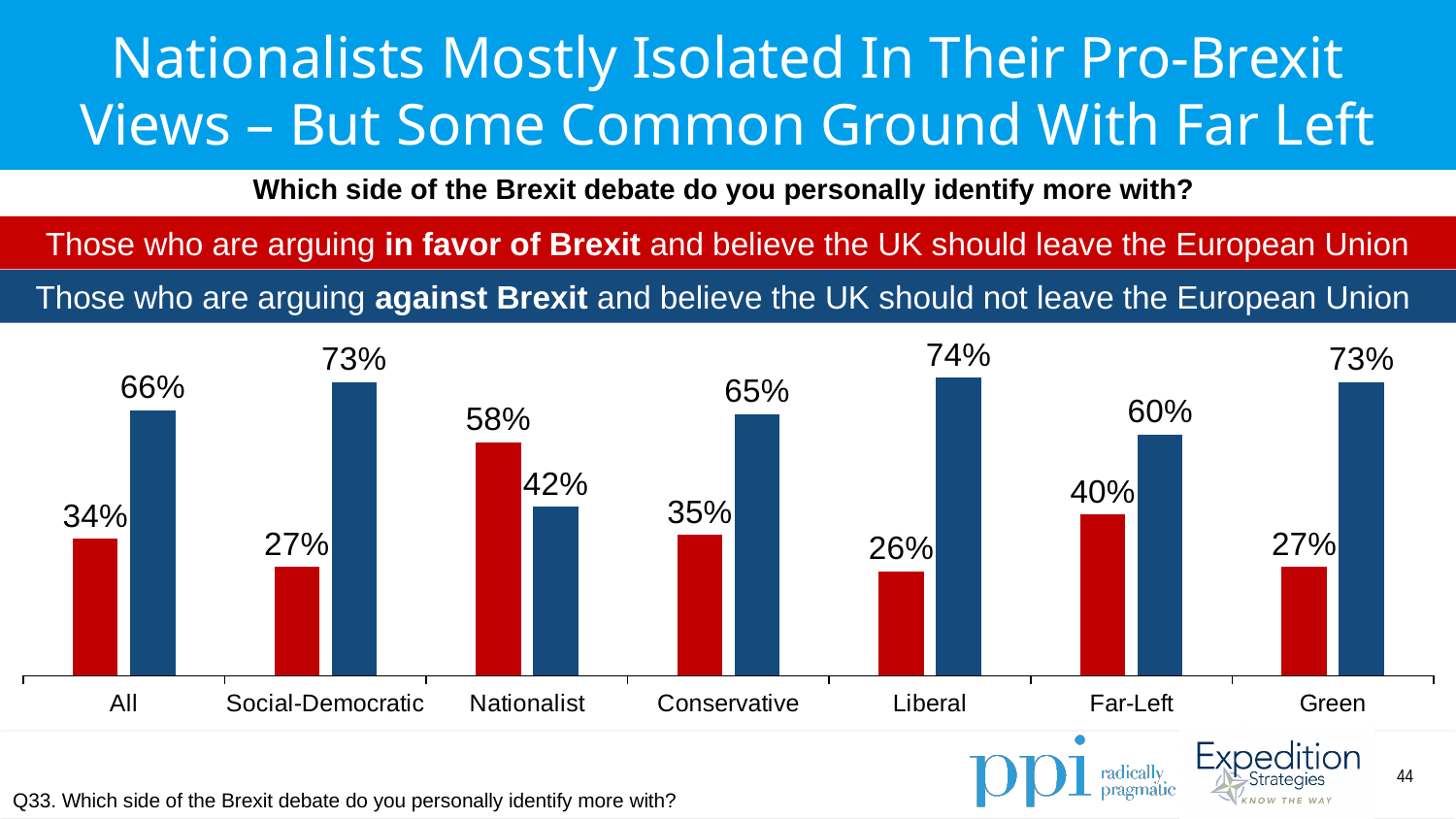
Which category has the lowest value for the red (in favor of Brexit) bar? Liberal What kind of chart is shown on the slide? Bar chart Which category has the highest value for the red (in favor of Brexit) bar? Nationalist How many categories are shown on the x axis of the chart? 7 What is the difference between the blue and red bars for the Far-Left category? 20 percentage points What is the value of the red (in favor of Brexit) bar for the All category? 34% What percentage of Liberal respondents identify with those arguing against Brexit (blue bar)? 74% Which category has the lowest value for the blue (against Brexit) bar? Nationalist Which colour represents those arguing in favor of Brexit? Red What percentage of Nationalist respondents identify with those arguing in favor of Brexit (red bar)? 58% Which is larger for the Nationalist category: the red (in favor of Brexit) bar or the blue (against Brexit) bar? The red (in favor of Brexit) bar What is the difference between the red bars for Nationalist and Far-Left? 18 percentage points